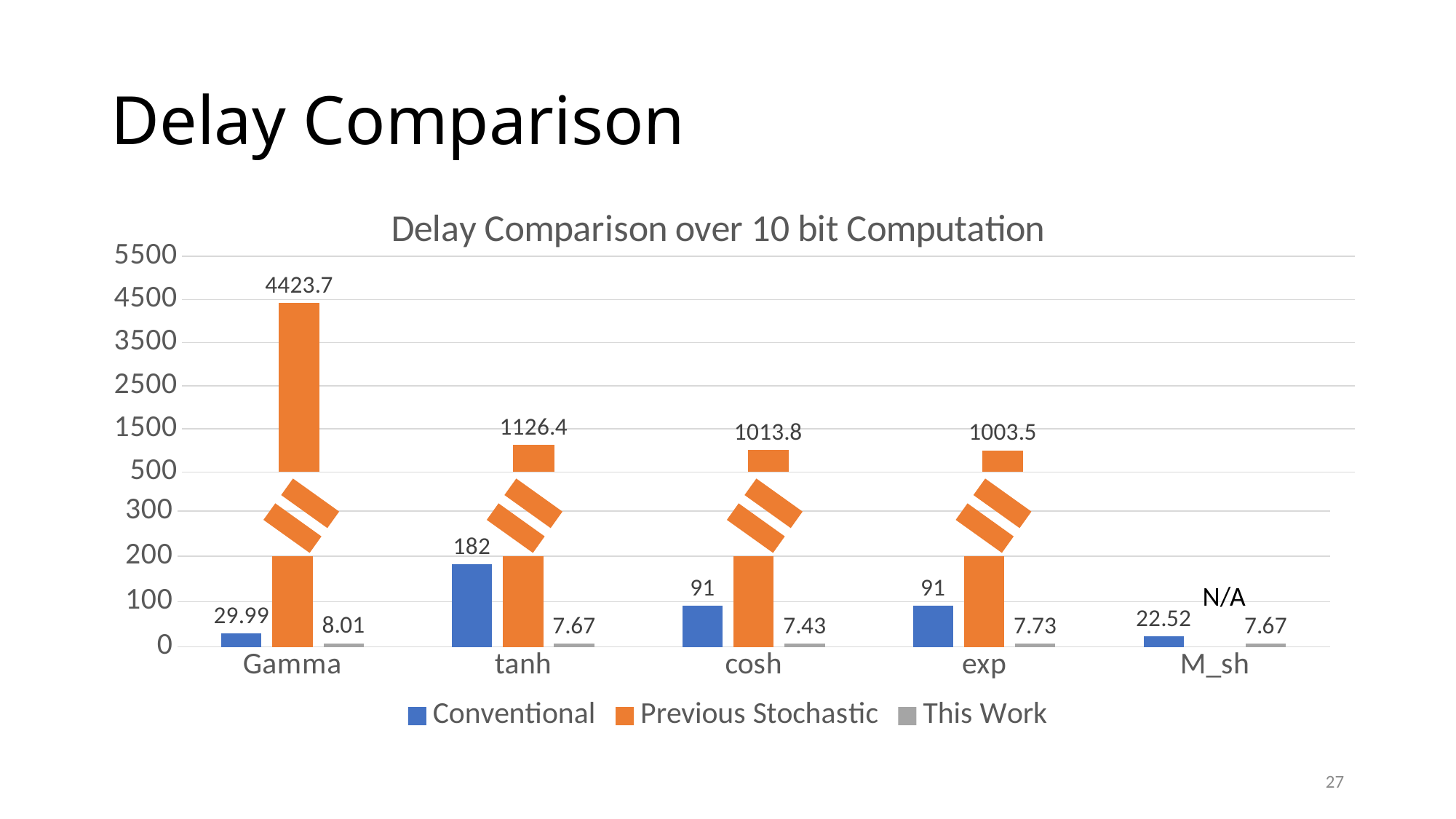
What is the title of the chart? Delay Comparison over 10 bit Computation What is the difference between the Conventional values for tanh and cosh? 91 What is the This Work value for cosh? 7.43 What is the Conventional value for tanh? 182 What kind of chart is shown? Bar chart Which category has the highest Previous Stochastic value? Gamma How many categories are shown on the x axis? 5 Which category has the lowest This Work value? cosh What is the Previous Stochastic value for Gamma? 4423.7 Which is larger, the Previous Stochastic value for tanh or for exp? tanh How many series does the legend list? 3 What is the Previous Stochastic value for M_sh? N/A